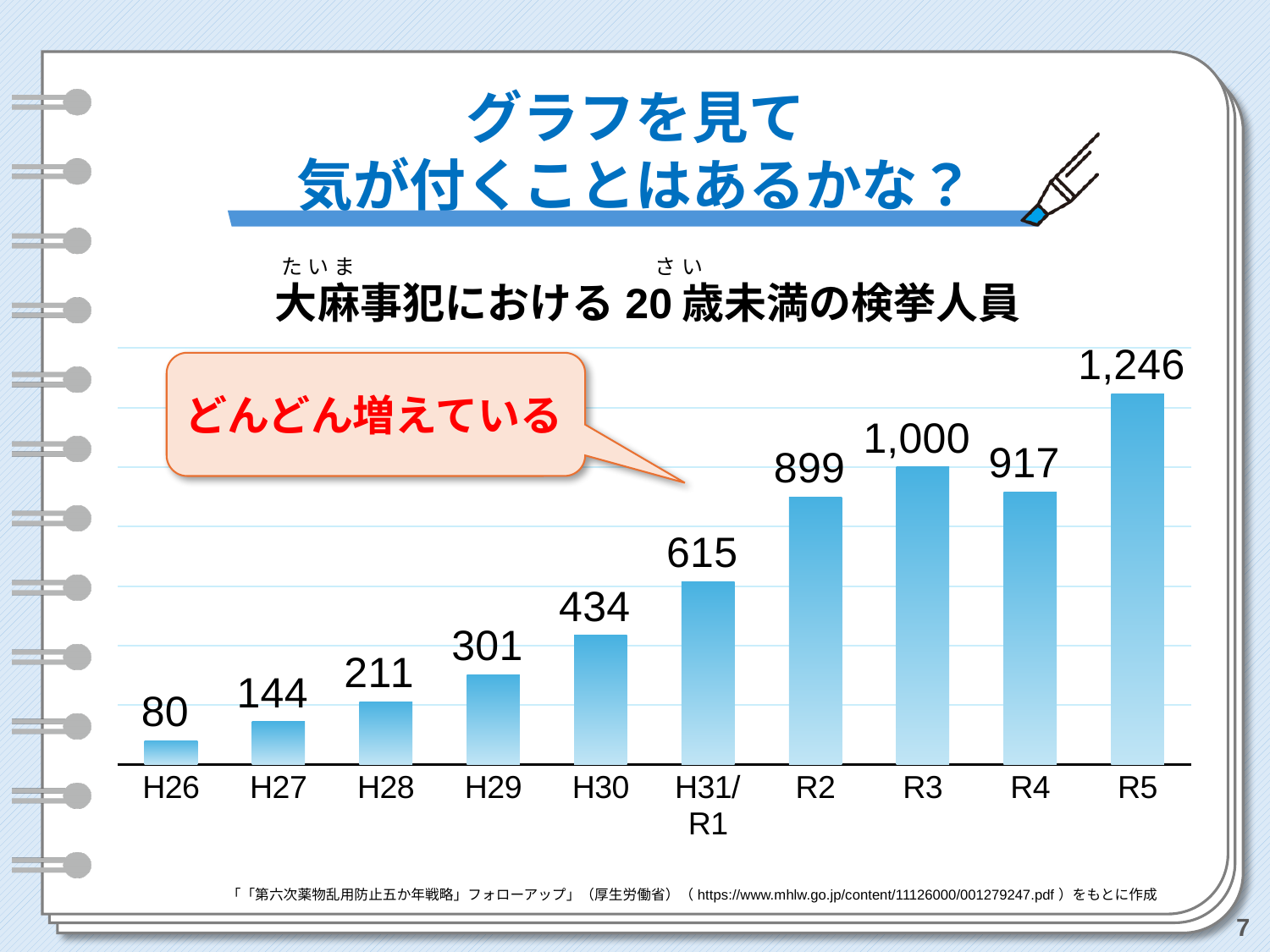
What is the difference between the values for R5 and H26? 1,166 What kind of chart is this? Bar chart What is the title of the chart? 大麻事犯における20歳未満の検挙人員 What is the difference between the values for R3 and R4? 83 Which category has the lowest value? H26 Which is larger, the value for R2 or the value for R4? R4 What is the value for H26? 80 What is the value for H31/R1? 615 Which category has the highest value? R5 How many categories are shown on the x axis? 10 What is the value for R5? 1,246 What is the value for R3? 1,000